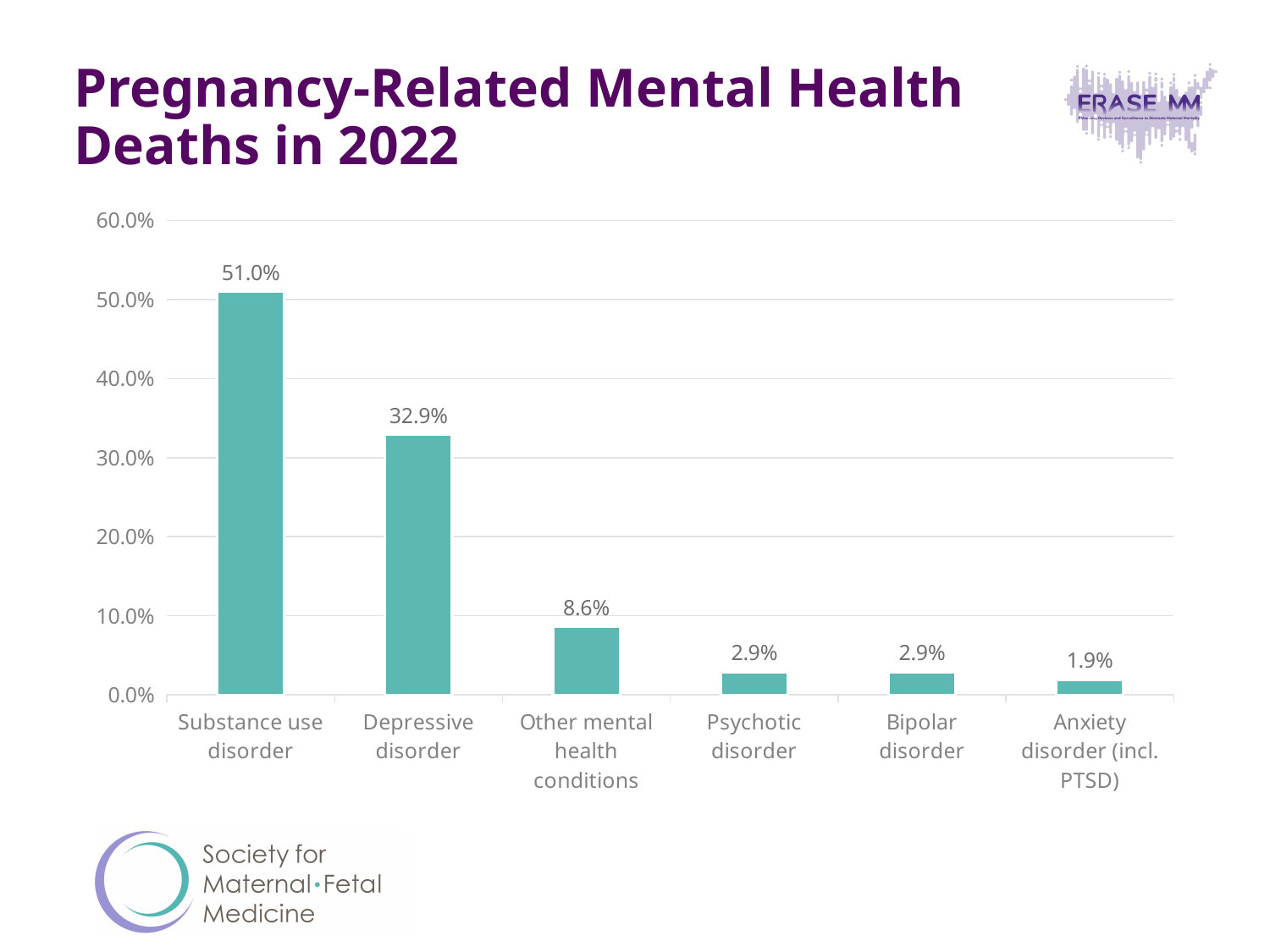
What is the title of the chart on the slide? Pregnancy-Related Mental Health Deaths in 2022 What is the value for anxiety disorder (incl. PTSD)? 1.9% Which category has the lowest percentage? Anxiety disorder (incl. PTSD) What is the value shown for depressive disorder? 32.9% Which category has the highest percentage? Substance use disorder How many categories are shown on the x axis? 6 What is the difference in percentage points between substance use disorder and depressive disorder? 18.1 percentage points Is the value for substance use disorder greater or less than 50.0%? greater What kind of chart is shown on the slide? Bar chart What percentage of pregnancy-related mental health deaths in 2022 were attributed to substance use disorder? 51.0% Which is larger, the value for depressive disorder or the value for other mental health conditions? Depressive disorder What percentage is shown for other mental health conditions? 8.6%